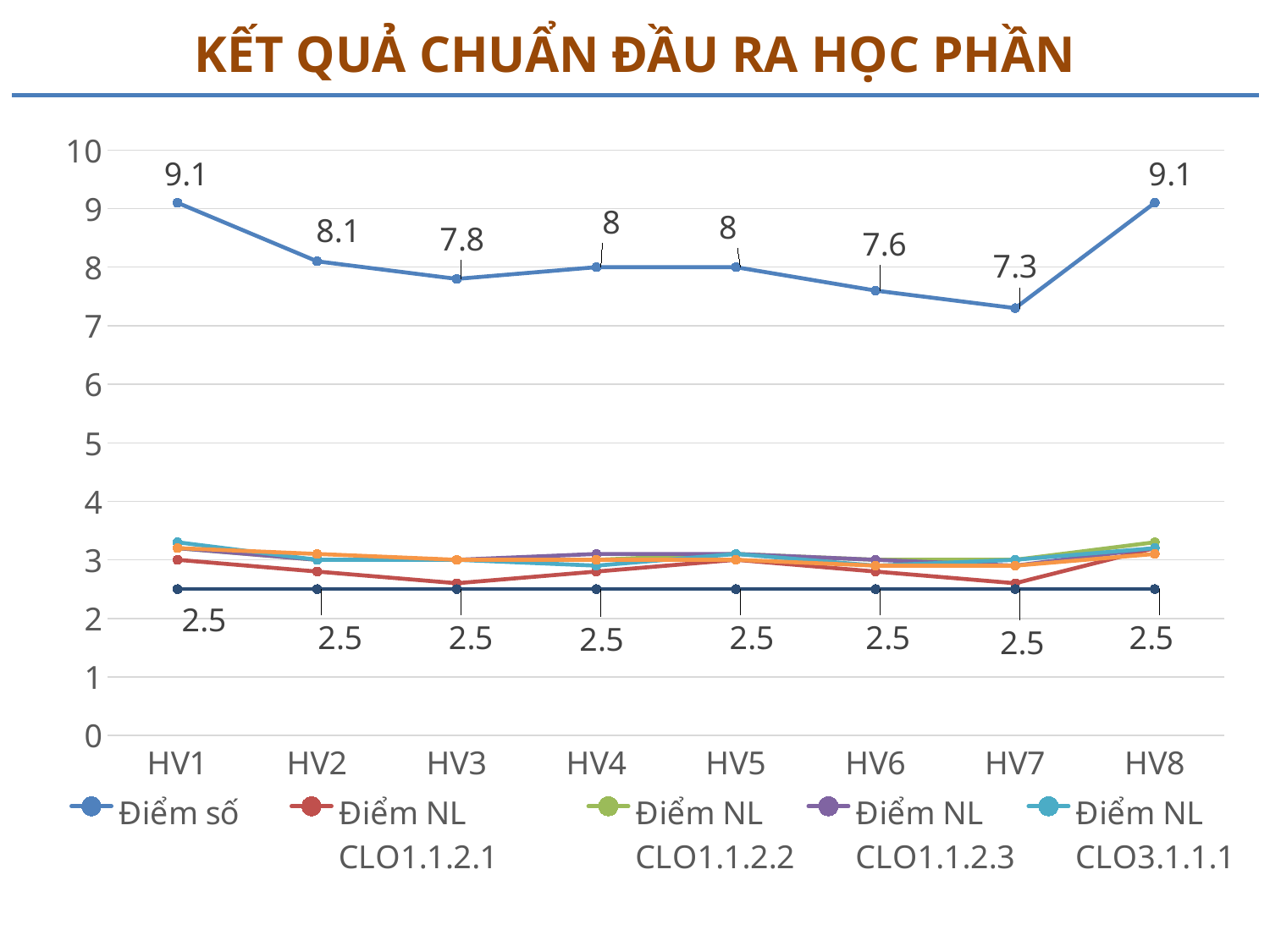
What is the difference between the Điểm số values for HV1 and HV7? 1.8 What is the value of Điểm số for HV7? 7.3 What is the value of Điểm số for HV1? 9.1 How many categories are shown on the x axis? 8 What is the value of Điểm số for HV3? 7.8 What kind of chart is shown on the slide? line chart How many series does the legend list? 5 Does the Điểm số series rise or fall from HV1 to HV3? fall Which has the larger Điểm số value, HV2 or HV6? HV2 Is the Điểm số value for HV4 greater or less than 7? greater Which category has the lowest Điểm số value? HV7 What is the difference between the Điểm số values for HV2 and HV3? 0.3